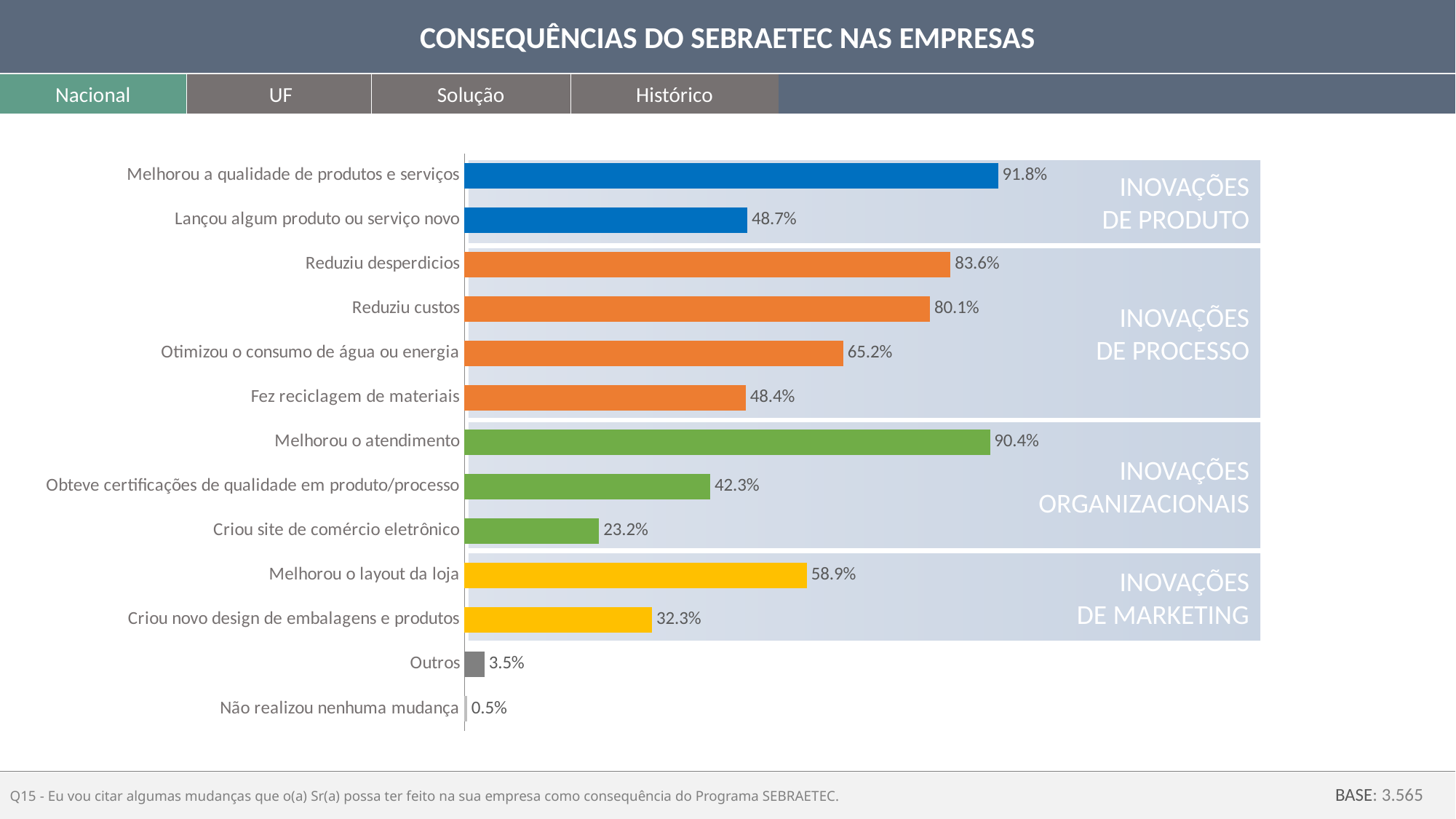
What is the value for "Reduziu custos"? 80.1% What is the value for "Melhorou o layout da loja"? 58.9% What is the value for "Criou site de comércio eletrônico"? 23.2% Which is larger, "Otimizou o consumo de água ou energia" or "Melhorou o layout da loja"? Otimizou o consumo de água ou energia What is the difference between "Melhorou o atendimento" and "Obteve certificações de qualidade em produto/processo"? 48.1% Which category has the lowest value? Não realizou nenhuma mudança How many categories are shown in the chart? 13 Which category has the highest value? Melhorou a qualidade de produtos e serviços What kind of chart is shown on the slide? Bar chart What is the value for "Melhorou a qualidade de produtos e serviços"? 91.8% Which group label is shown next to the orange bars? INOVAÇÕES DE PROCESSO What is the difference between "Reduziu desperdicios" and "Reduziu custos"? 3.5%